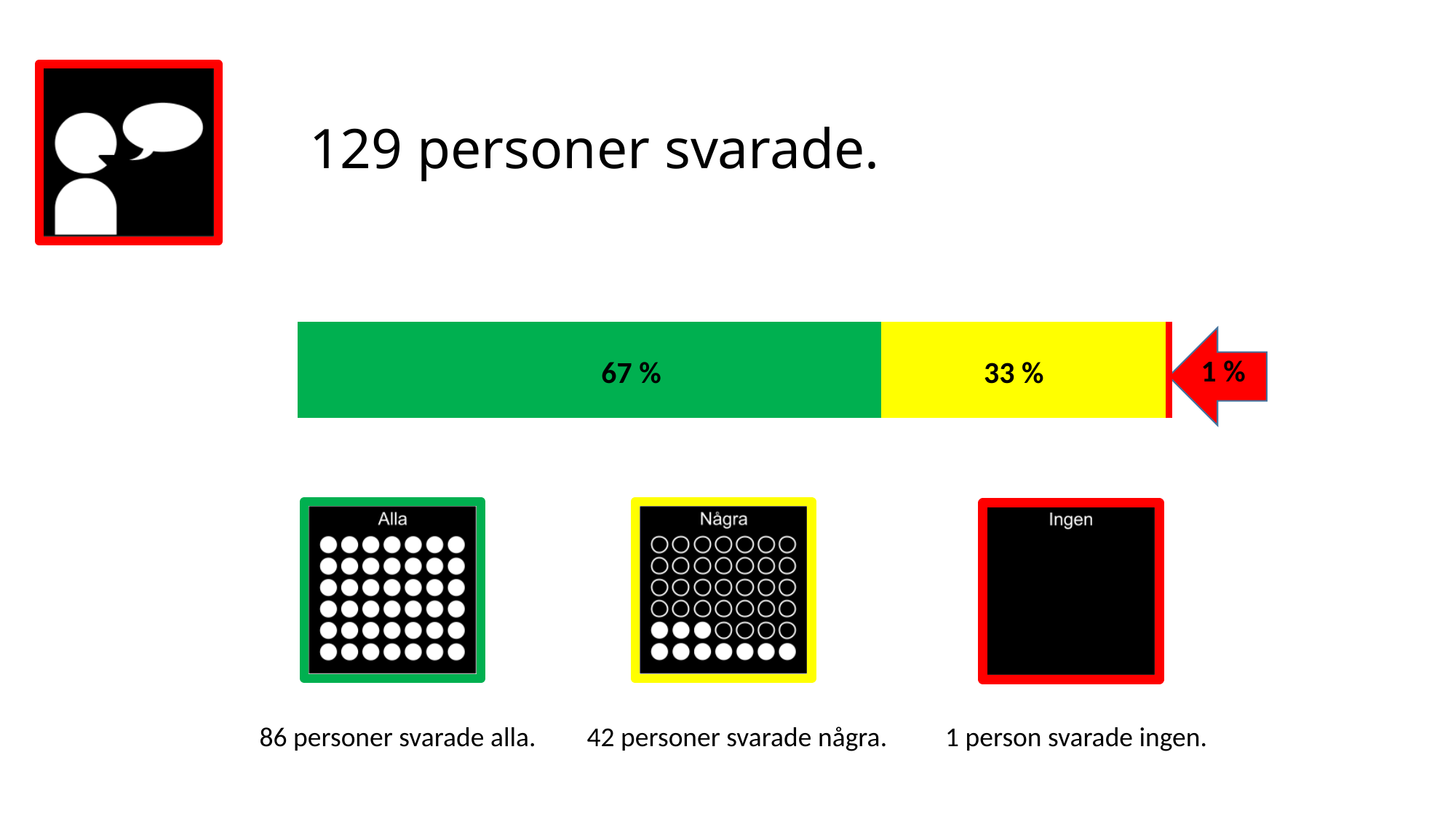
What kind of chart is shown on the slide? a stacked bar chart How many people answered 'några' according to the slide? 42 What percentage is shown on the green segment of the bar? 67 % Which is larger, the green segment or the yellow segment? the green segment (67 %) What is the difference in percentage points between the green segment and the yellow segment? 34 What percentage does the red arrow point to on the bar? 1 % What percentage is shown on the yellow segment of the bar? 33 % Which segment of the bar is the largest? 67 % (green, Alla) What colour is the segment corresponding to 'Ingen'? red How many people answered 'alla' according to the slide? 86 How many segments does the bar have? 3 Which segment of the bar is the smallest? 1 % (red, Ingen)